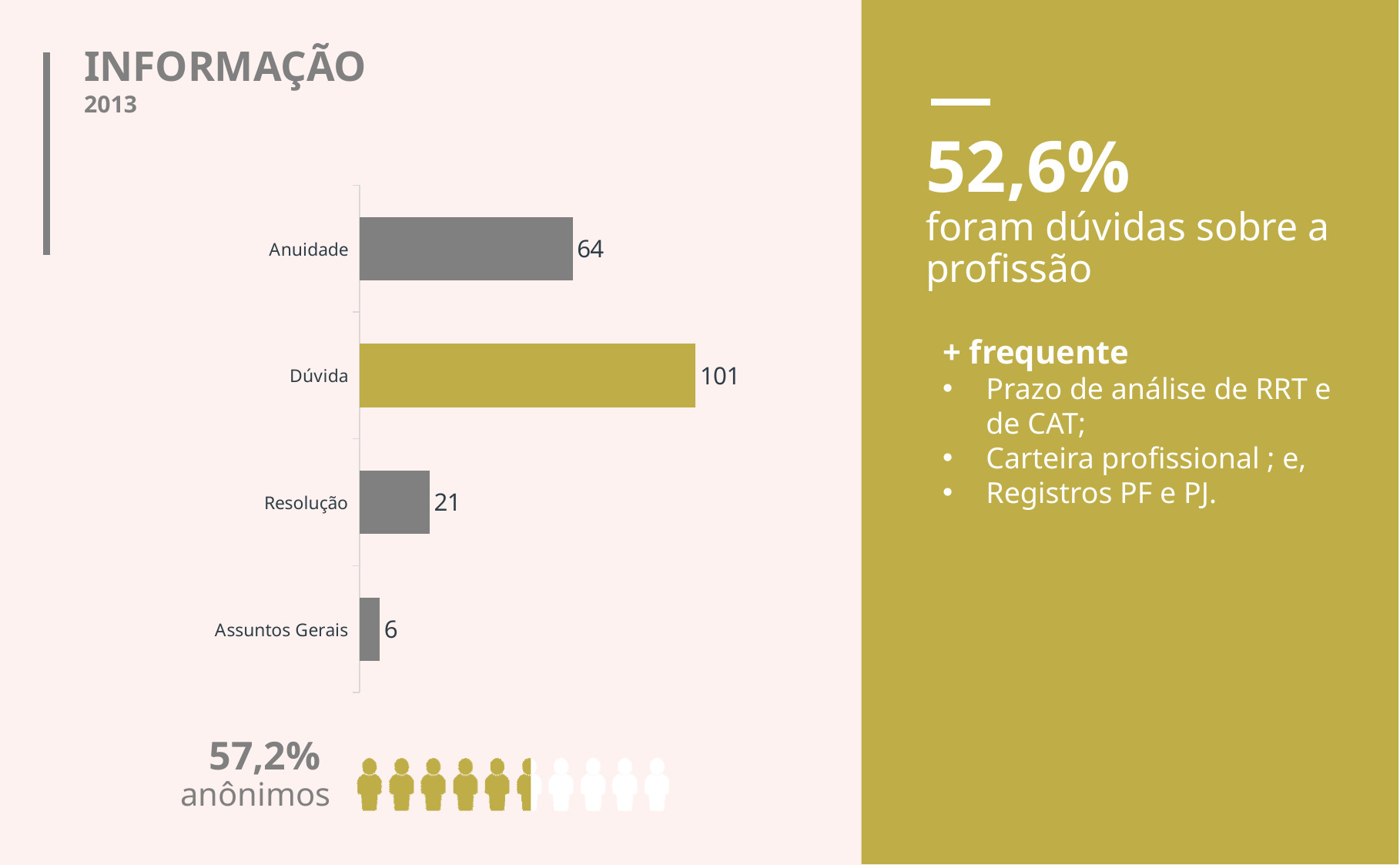
How many categories are shown in the chart? 4 Which bar in the chart is highlighted in a different colour (gold) from the others? Dúvida What is the value for Resolução? 21 What is the value for Assuntos Gerais? 6 What is the difference between the values for Dúvida and Anuidade? 37 Which is larger, the value for Anuidade or the value for Resolução? Anuidade Which category has the lowest value? Assuntos Gerais What is the difference between the values for Resolução and Assuntos Gerais? 15 What kind of chart is shown on the slide? bar chart What is the value for Dúvida? 101 Which category has the highest value? Dúvida What is the value for Anuidade? 64